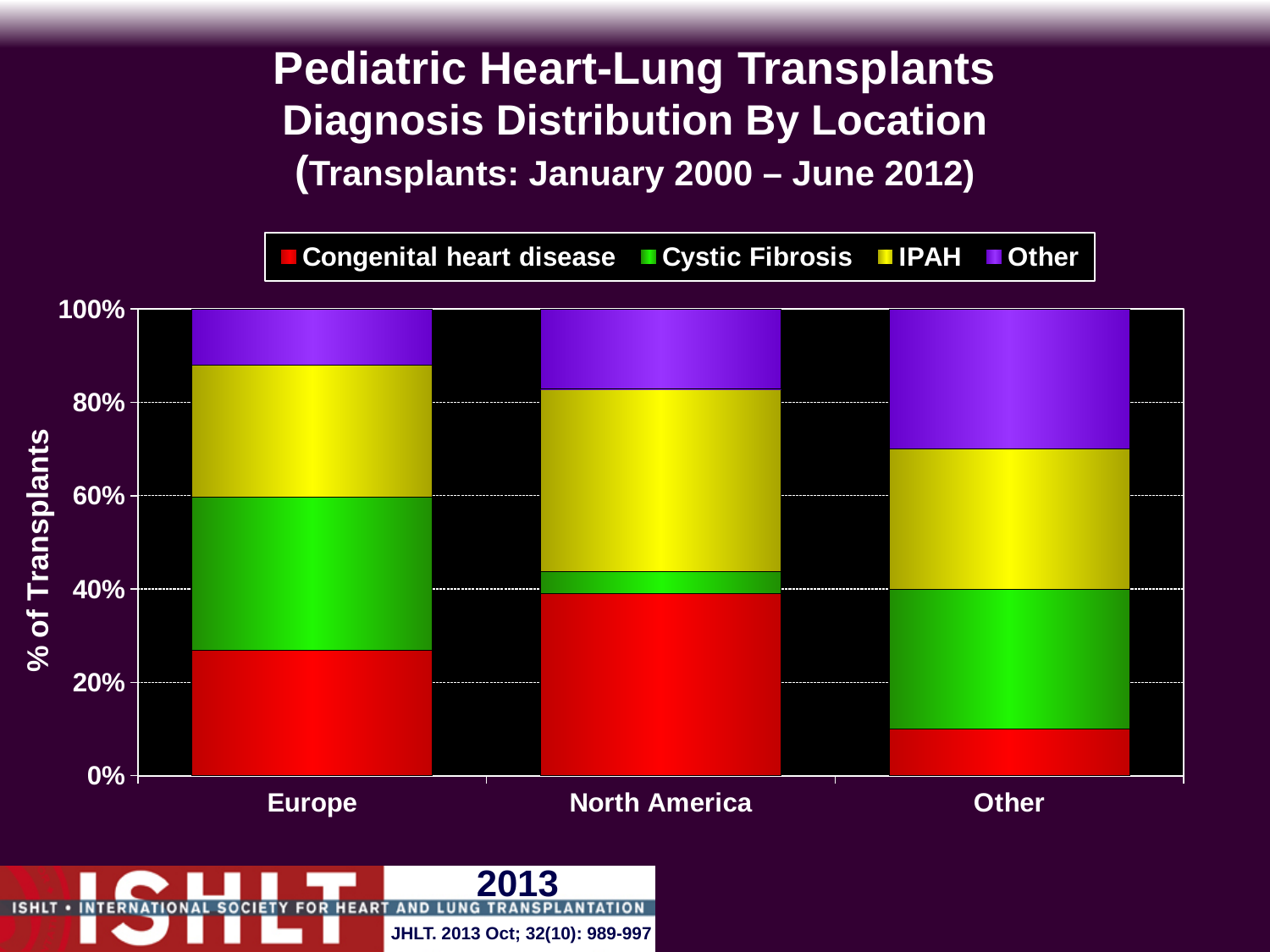
Which location has the largest 'Other' diagnosis segment? Other Which is larger, the Cystic Fibrosis segment for Europe or for North America? Europe What kind of chart is shown on the slide? Stacked bar chart Is the Cystic Fibrosis share for North America greater or less than 20%? less Which location has the smallest Cystic Fibrosis segment? North America What is the label on the y axis? % of Transplants Which location has the smallest Congenital heart disease segment? Other Is the Congenital heart disease share for the Other location greater or less than 20%? less How many diagnosis series does the legend list? 4 How many locations are shown along the x axis? 3 Which location has the largest Congenital heart disease segment? North America Is the Congenital heart disease share for Europe greater or less than 20%? greater